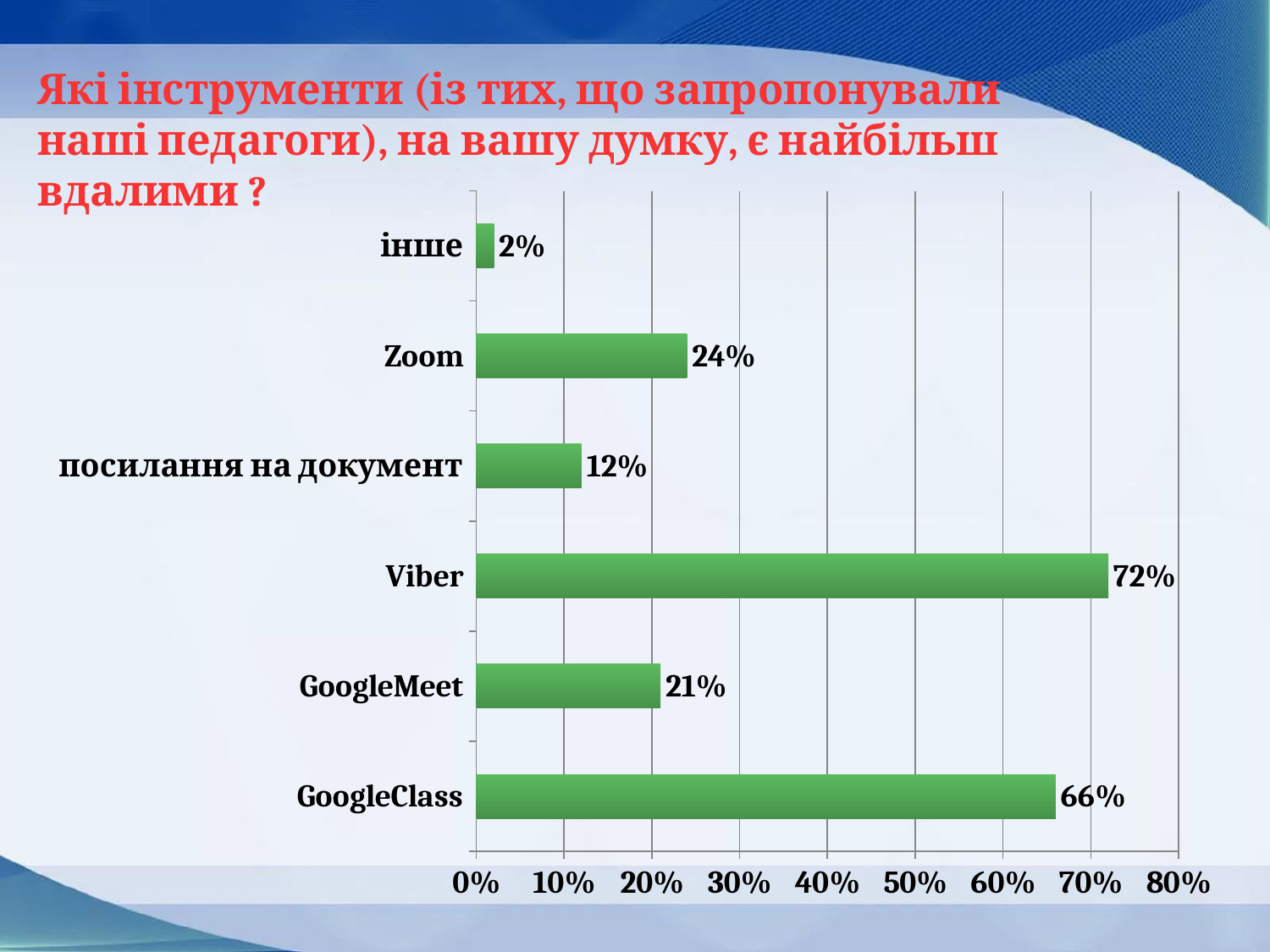
Which category has the highest value? Viber How many categories are shown in the chart? 6 What is the difference between the values for Viber and GoogleClass? 6% What is the value for Zoom? 24% Which category has the lowest value? інше What is the value for посилання на документ? 12% Which is larger, the value for Zoom or the value for GoogleMeet? Zoom What is the value for GoogleClass? 66% What is the value for Viber? 72% What colour are the bars in the chart? green What kind of chart is shown on the slide? bar chart Is the value for GoogleClass greater or less than 60%? greater